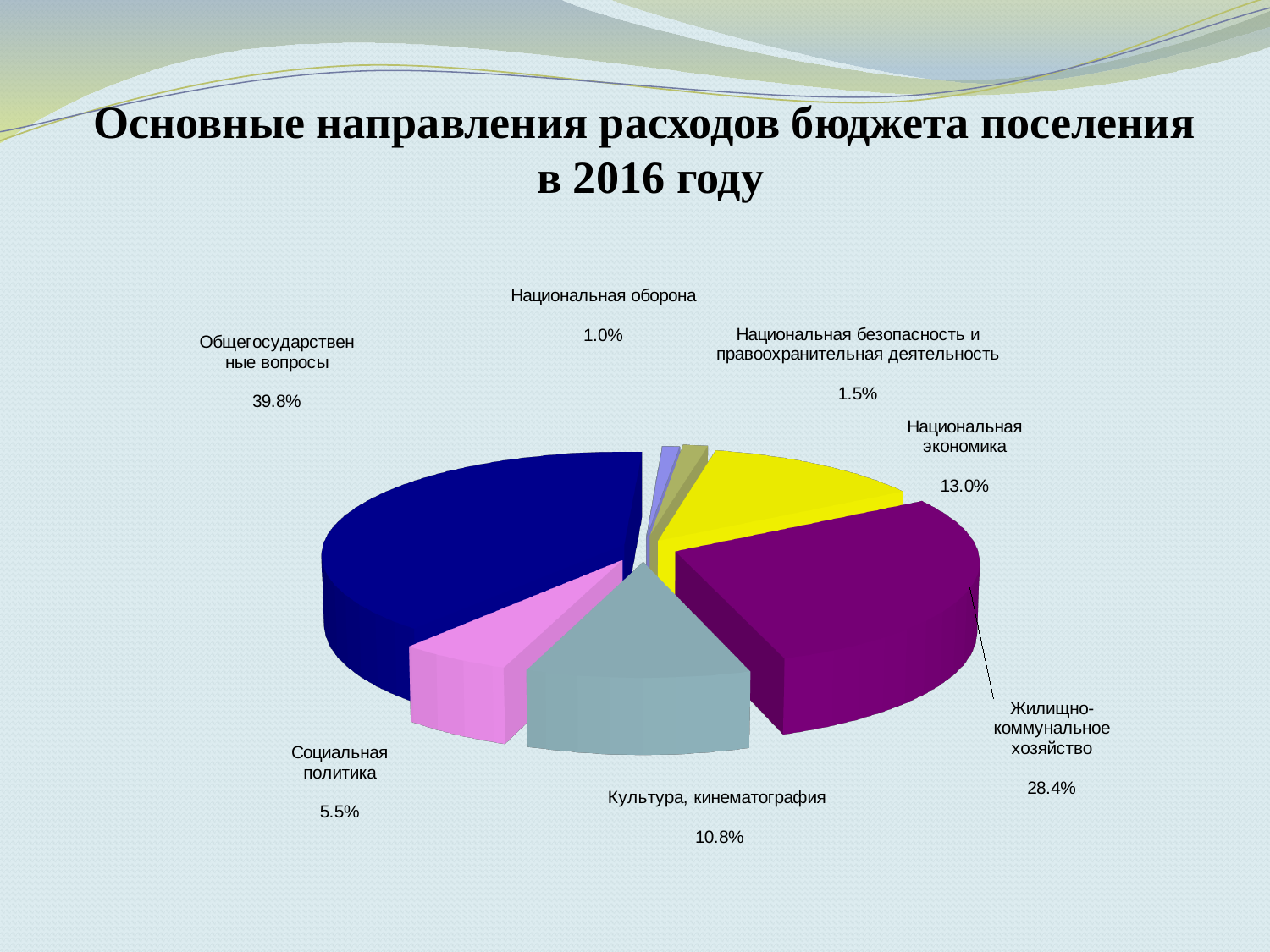
What share of the pie does Общегосударственные вопросы have? 39.8% Which category has the smallest share of the pie? Национальная оборона Which category has the largest share of the pie? Общегосударственные вопросы What percentage is labelled for Национальная экономика? 13.0% How many categories are shown in the pie chart? 7 What is the difference between the shares of Общегосударственные вопросы and Жилищно-коммунальное хозяйство? 11.4% Which is larger: Национальная экономика or Культура, кинематография? Национальная экономика What is the value for Национальная оборона? 1.0% What share is shown for Социальная политика? 5.5% What is the value shown for Жилищно-коммунальное хозяйство? 28.4% What is the value for Культура, кинематография? 10.8% What type of chart is shown on the slide? Pie chart